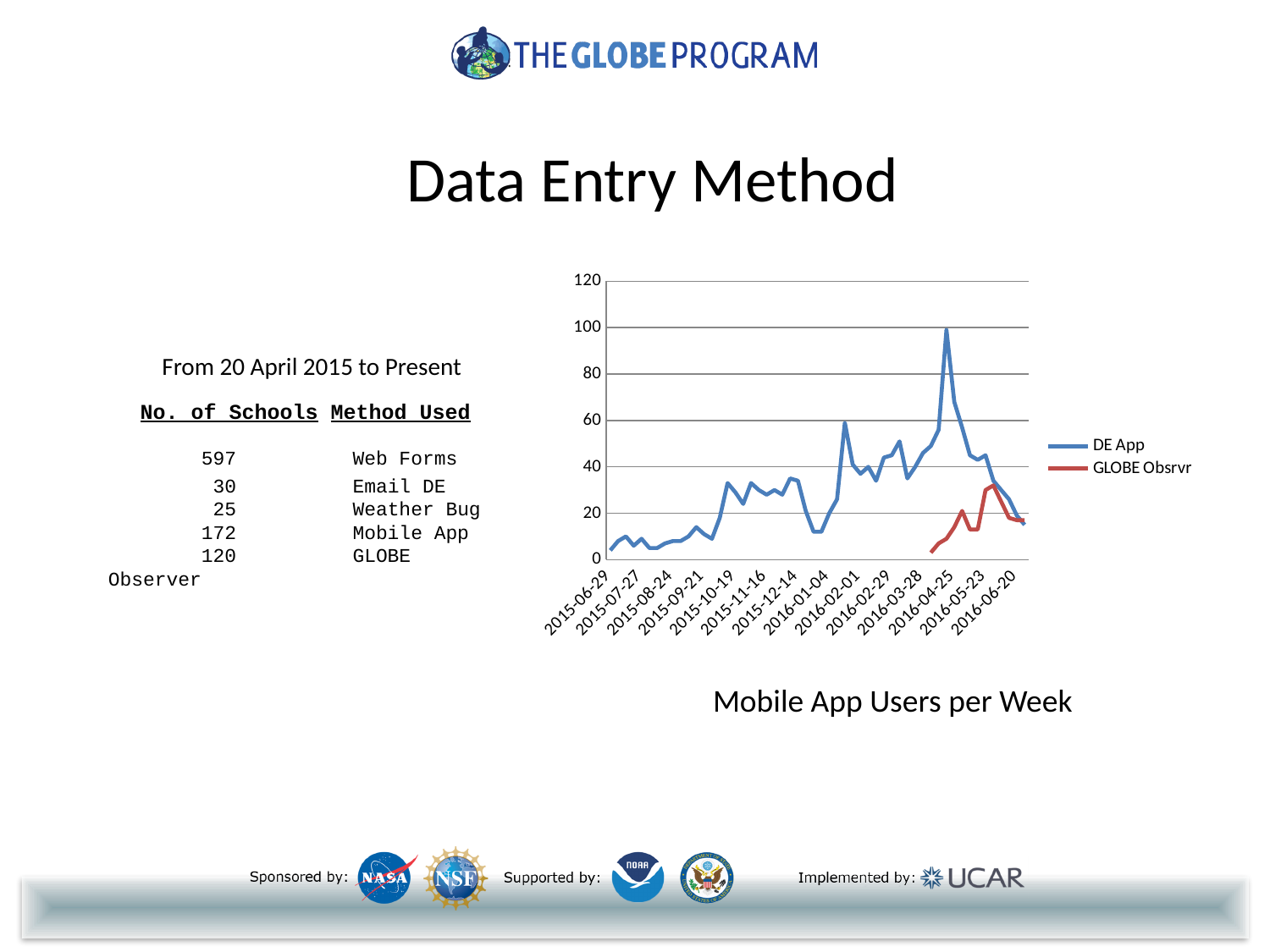
What kind of chart is shown on the slide? line chart Does the GLOBE Obsrvr series rise or fall from its first point to its peak near 2016-05-23? rise Which series reaches the higher peak, DE App or GLOBE Obsrvr? DE App Which series begins later on the x axis, DE App or GLOBE Obsrvr? GLOBE Obsrvr What are the two series named in the chart legend? DE App and GLOBE Obsrvr Does the DE App series rise or fall between its peak near 2016-04-25 and 2016-06-20? fall What is the highest value shown on the chart's y axis? 120 What is the title shown beneath the chart? Mobile App Users per Week Is the peak value of the GLOBE Obsrvr series greater or less than 40? less Is the peak value of the DE App series greater or less than 80? greater Is the DE App value at 2015-06-29 greater or less than 20? less How many series does the legend of the chart list? 2